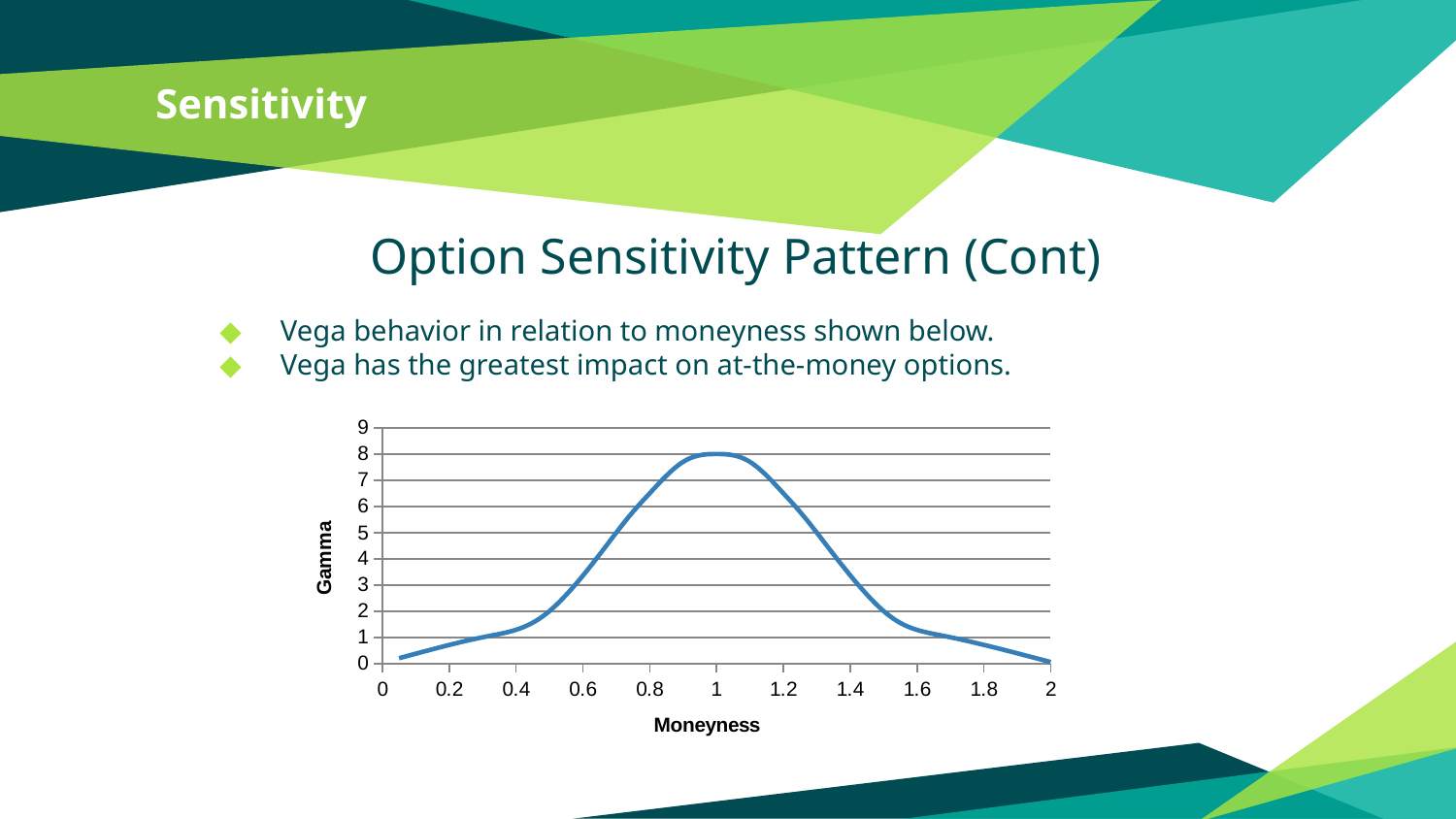
Does the Gamma curve rise or fall as Moneyness increases from 0 to 1? rise Which has the larger Gamma value: Moneyness 1 or Moneyness 2? Moneyness 1 Does the Gamma curve rise or fall as Moneyness increases from 1 to 2? fall Is the Gamma value at Moneyness 0.4 greater or less than 2? less Is the Gamma value at Moneyness 1.8 greater or less than 1? less Is the Gamma value at Moneyness 0.8 greater or less than 5? greater What kind of chart is shown on the slide? line chart At which Moneyness value does the Gamma curve reach its highest point? 1 What is the label of the x axis of the chart? Moneyness What is the peak Gamma value reached by the curve? 8 What is the label of the y axis of the chart? Gamma